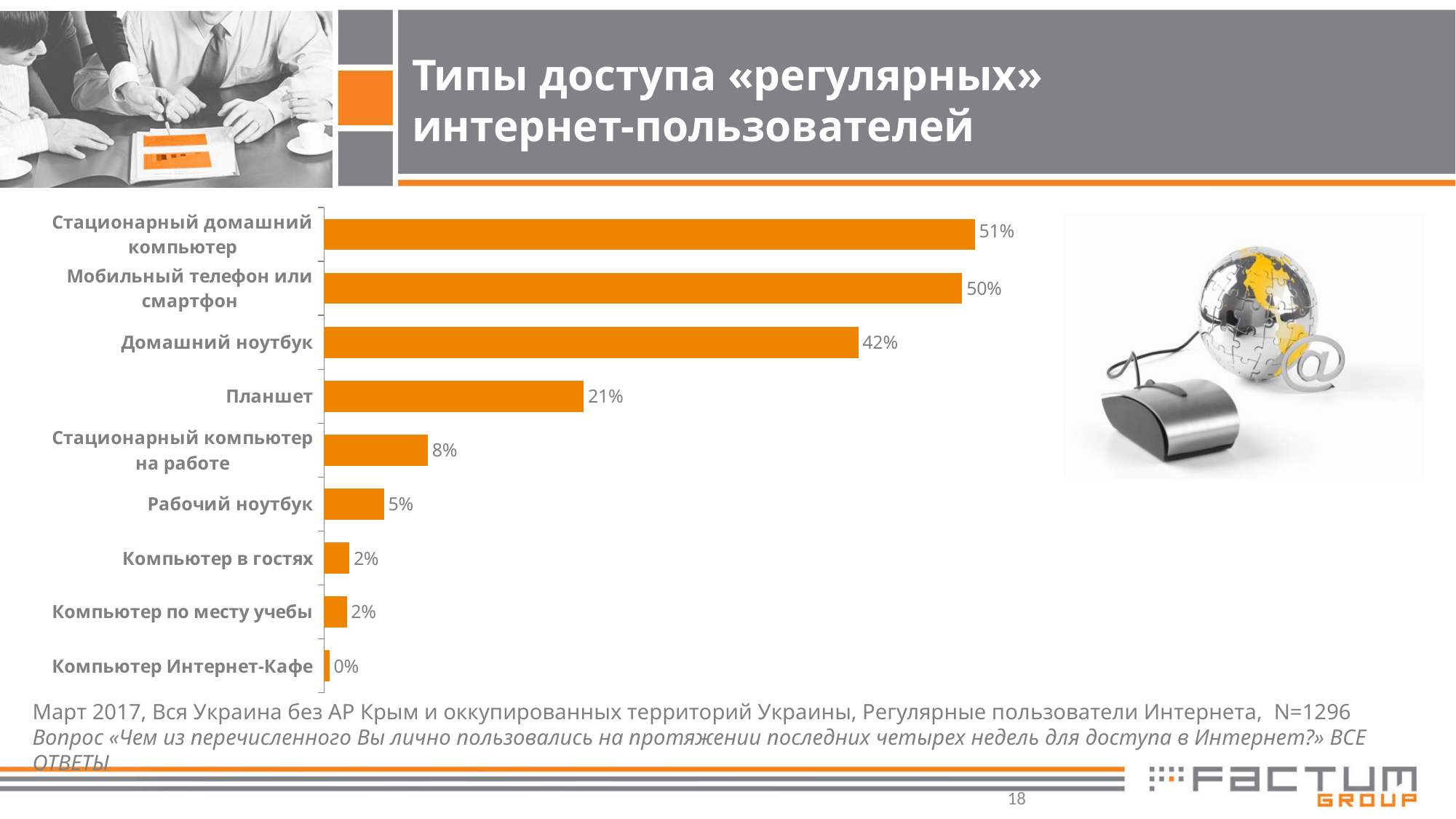
Which category has the lowest value? Компьютер Интернет-Кафе What is the difference between the values for Мобильный телефон или смартфон and Стационарный компьютер на работе? 42% What is the value for Планшет? 21% Which category has the highest value? Стационарный домашний компьютер What kind of chart is shown on the slide? Bar chart What is the value for Стационарный домашний компьютер? 51% What is the difference between the values for Домашний ноутбук and Планшет? 21% How many categories are shown in the chart? 9 What is the value for Рабочий ноутбук? 5% What colour are the bars in the chart? Orange Which is larger: the value for Домашний ноутбук or the value for Планшет? Домашний ноутбук What is the value for Компьютер Интернет-Кафе? 0%